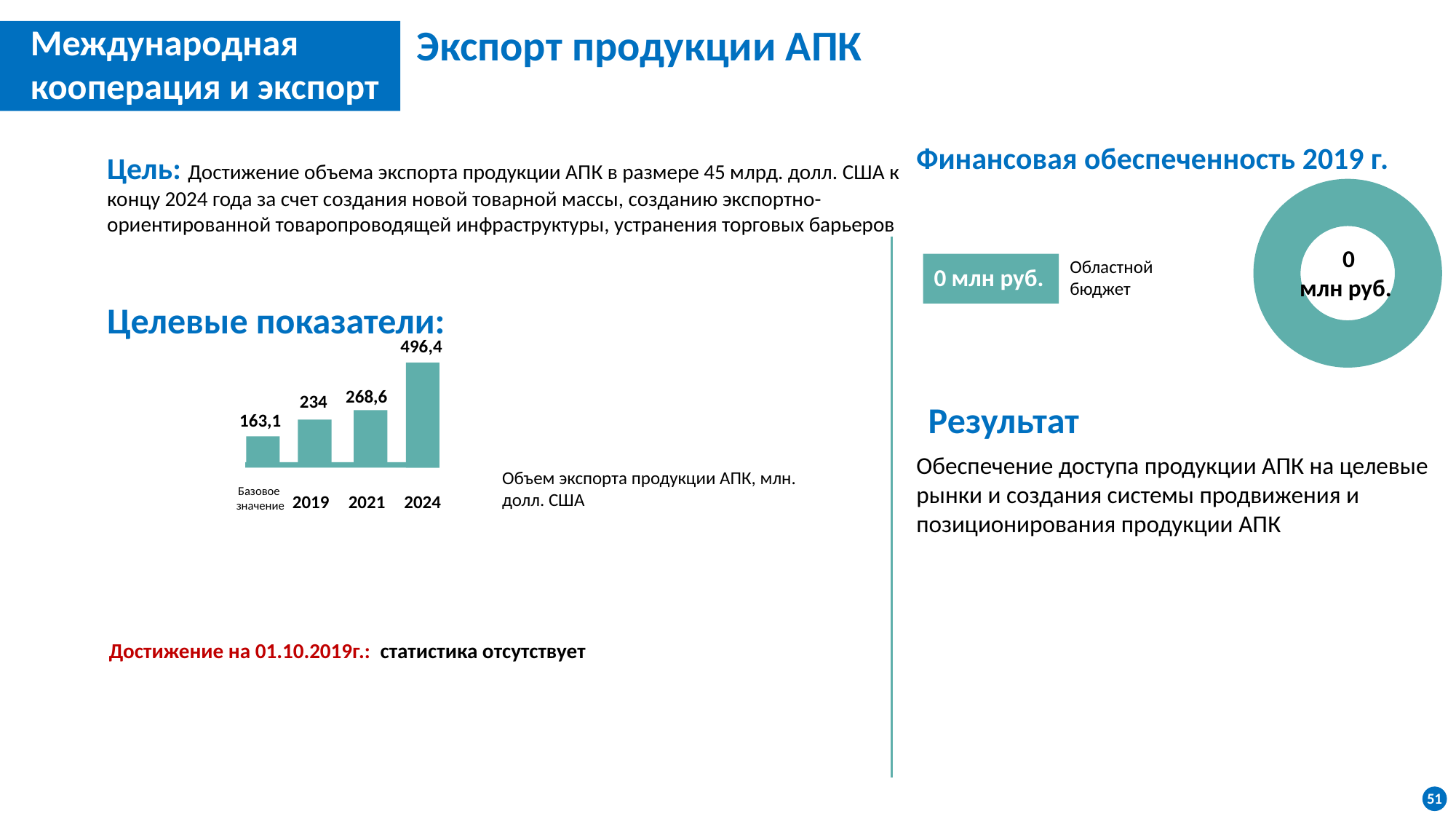
On the bar chart under 'Целевые показатели', do the values rise or fall from 'Базовое значение' to 2024? Rise What kind of chart is shown under 'Целевые показатели'? Bar chart On the donut chart under 'Финансовая обеспеченность 2019 г.', what value is shown in the centre? 0 млн руб. On the bar chart under 'Целевые показатели', which is larger: the value for 2019 or the value for 2021? 2021 On the bar chart under 'Целевые показатели', what is the difference between the 2024 value and the 'Базовое значение' value? 333,3 On the bar chart under 'Целевые показатели', which category has the lowest value? Базовое значение On the bar chart under 'Целевые показатели', what is the difference between the 2021 and 2019 values? 34,6 On the bar chart under 'Целевые показатели', how many bars are plotted? 4 On the bar chart under 'Целевые показатели', what is the value for 'Базовое значение'? 163,1 On the bar chart under 'Целевые показатели', what is the value for 2021? 268,6 On the bar chart under 'Целевые показатели', what is the value for 2024? 496,4 On the bar chart under 'Целевые показатели', which category has the highest value? 2024